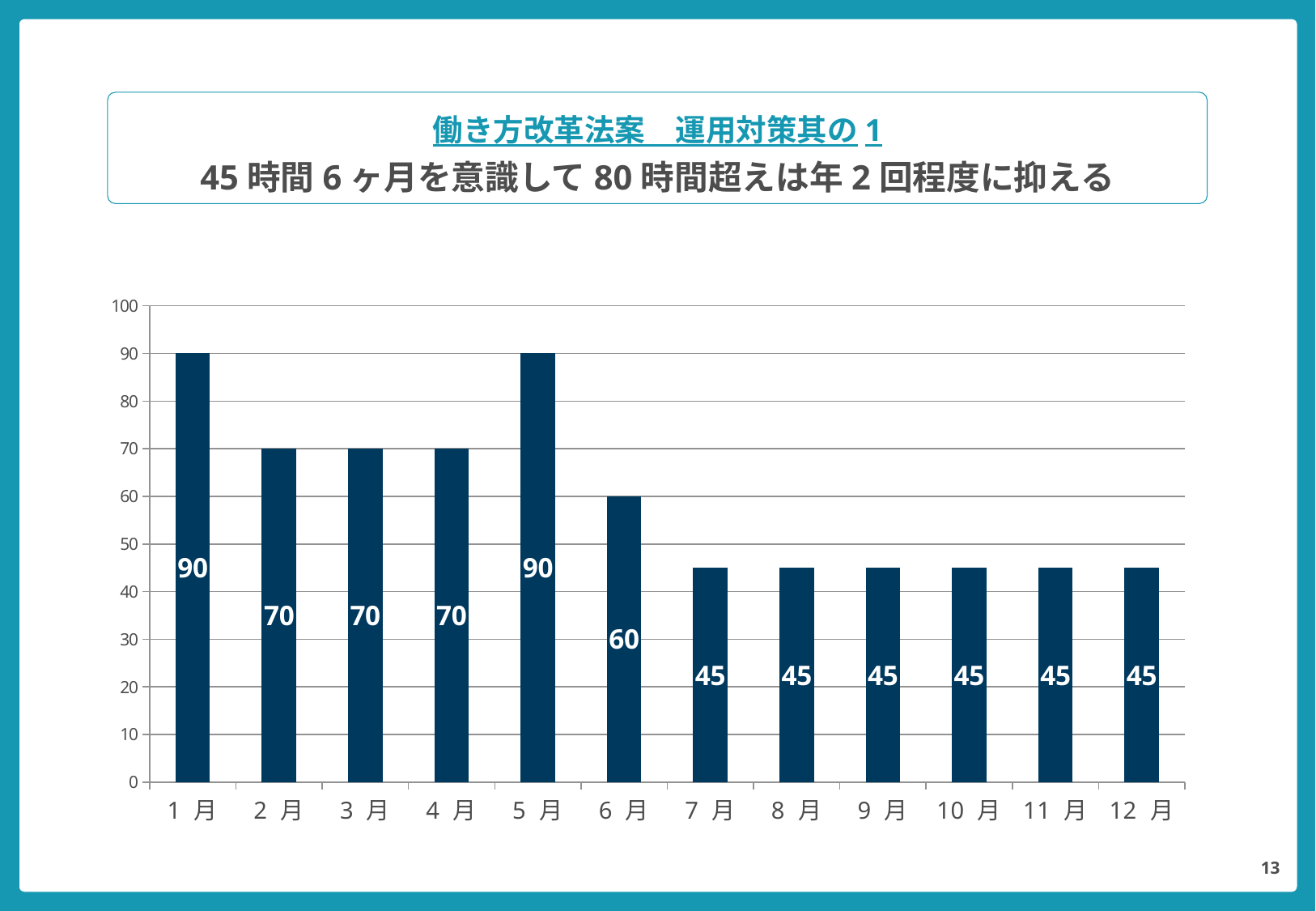
How many months are shown on the x axis? 12 Which months have the highest value? 1月 and 5月 What is the value for 10月? 45 Is the value for 4月 greater or less than 60? greater What is the lowest value shown in the chart? 45 What is the value for 6月? 60 What is the difference between the values for 5月 and 6月? 30 What is the value for 1月? 90 Which is larger, the value for 2月 or the value for 7月? 2月 What kind of chart is shown on the slide? Bar chart How many months have a value of 45? 6 What is the value for 3月? 70